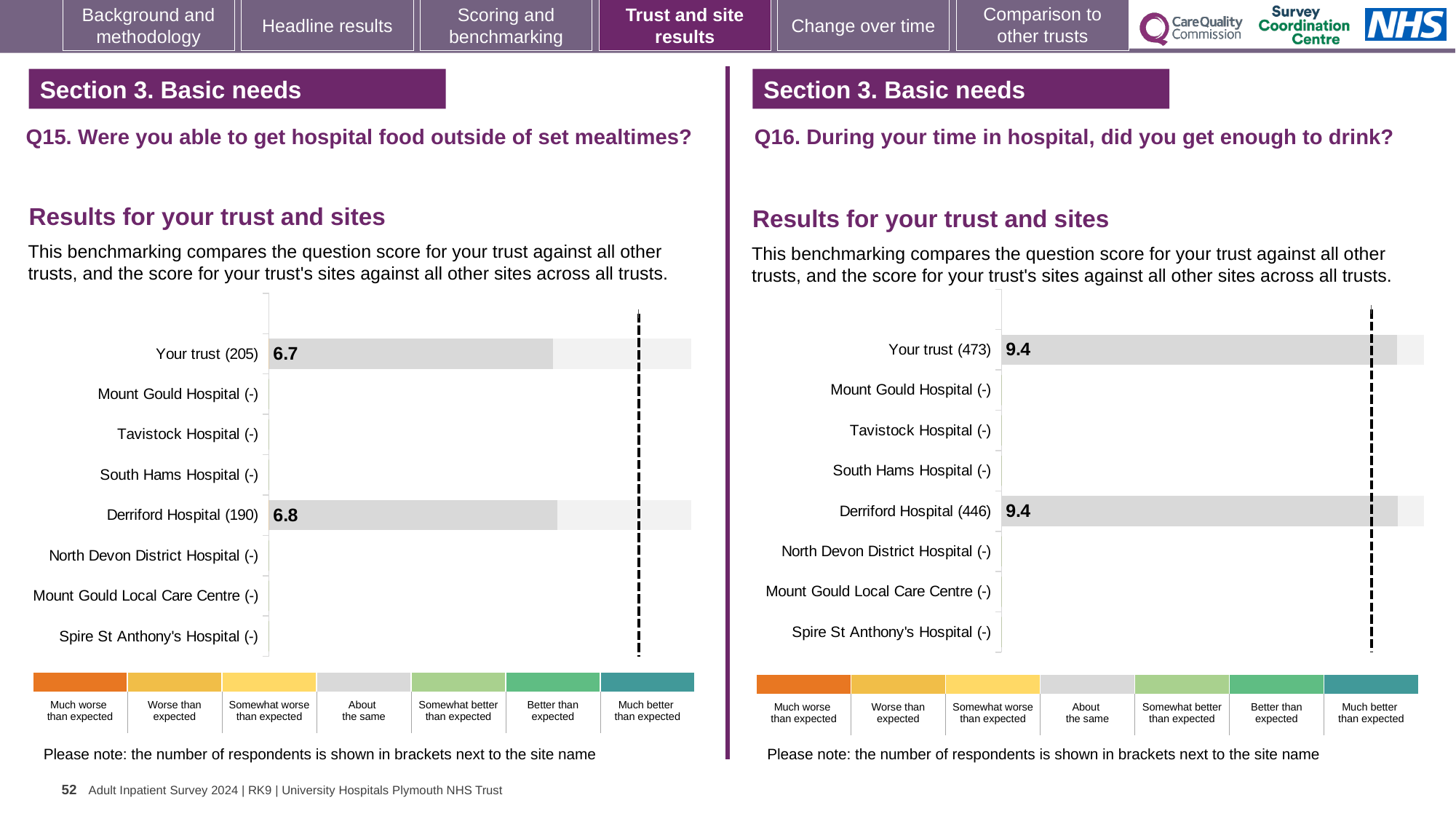
What type of chart is used on the Q16 chart (right)? Bar chart On the Q15 chart (left), what is the difference between the Derriford Hospital score and the Your trust score? 0.1 On the Q16 chart (right), how many categories have a plotted bar with a score shown? 2 On the Q16 chart (right), what is the score for Derriford Hospital? 9.4 On the Q15 chart (left), what is the score for Your trust? 6.7 On the Q16 chart (right), how many respondents are shown in brackets for Your trust? 473 How many site/trust categories are listed on the Q15 chart (left)? 8 On the Q15 chart (left), what is the score for Derriford Hospital? 6.8 On the Q16 chart (right), what is the score for Your trust? 9.4 On the Q15 chart (left), which has the higher score: Your trust or Derriford Hospital? Derriford Hospital On the Q15 chart (left), how many respondents are shown in brackets for Derriford Hospital? 190 On the Q16 chart (right), what is the difference between the Your trust score and the Derriford Hospital score? 0